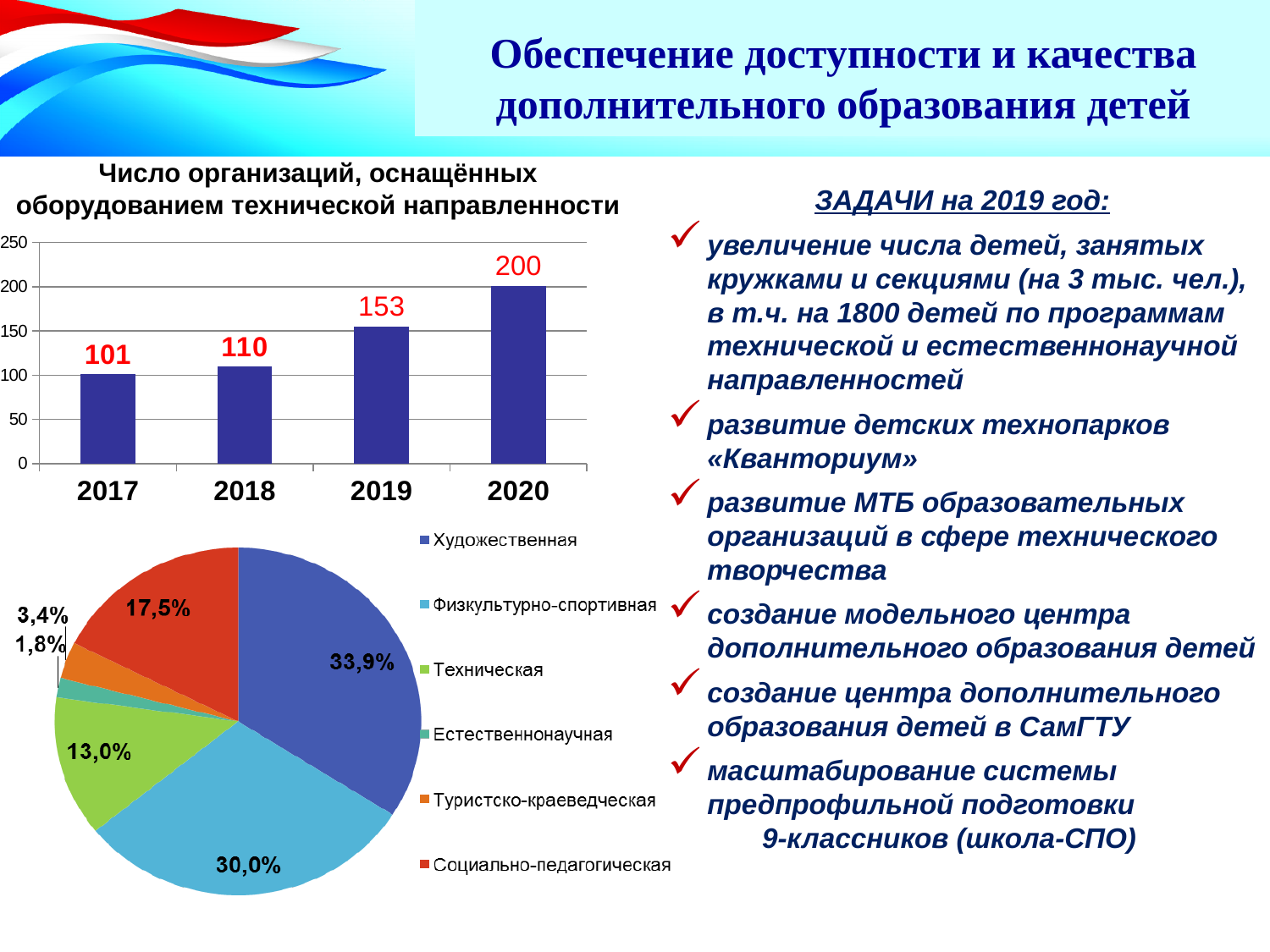
What kind of chart is the chart at the bottom left of the slide? pie chart How many years are shown in the bar chart 'Число организаций, оснащённых оборудованием технической направленности'? 4 In the bar chart 'Число организаций, оснащённых оборудованием технической направленности', what is the value for 2017? 101 In the pie chart at the bottom left, what share does 'Техническая' have? 13,0% In the bar chart 'Число организаций, оснащённых оборудованием технической направленности', what is the difference between the values for 2020 and 2018? 90 In the bar chart 'Число организаций, оснащённых оборудованием технической направленности', what is the value for 2019? 153 In the bar chart 'Число организаций, оснащённых оборудованием технической направленности', which year has the lowest value? 2017 In the bar chart 'Число организаций, оснащённых оборудованием технической направленности', which year has the highest value? 2020 In the pie chart at the bottom left, which is larger: 'Физкультурно-спортивная' or 'Социально-педагогическая'? Физкультурно-спортивная How many entries does the legend of the pie chart at the bottom left list? 6 In the pie chart at the bottom left, what share does 'Художественная' have? 33,9% In the bar chart 'Число организаций, оснащённых оборудованием технической направленности', do the values rise or fall from 2017 to 2020? rise